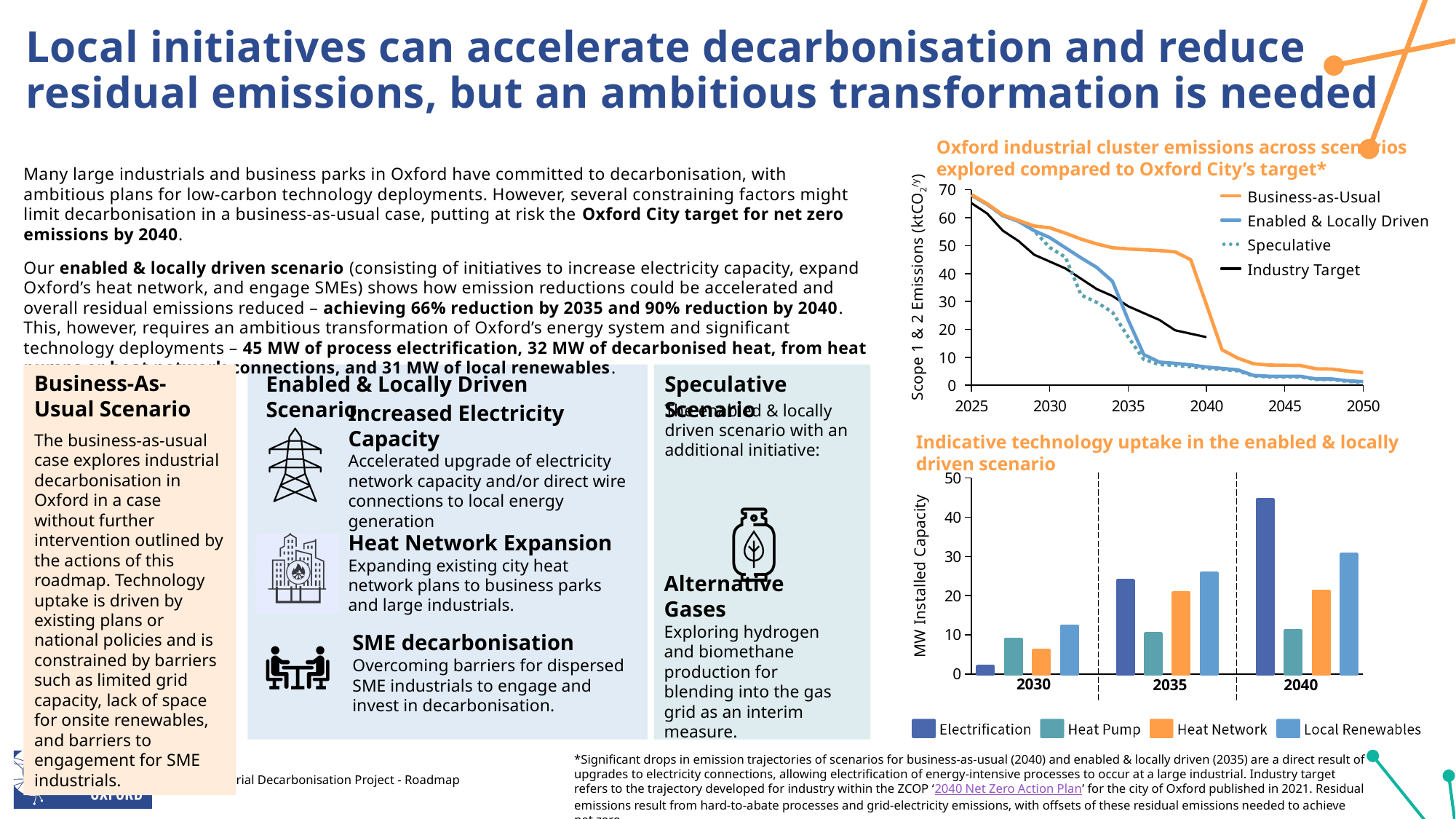
In the 'Indicative technology uptake' chart, is the Electrification value in 2040 greater or less than 40? greater How many year categories are shown on the x axis of the 'Indicative technology uptake' chart? 3 How many series does the legend of the 'Oxford industrial cluster emissions across scenarios' chart list? 4 What type of chart is the 'Indicative technology uptake in the enabled & locally driven scenario' chart? Bar chart In the 'Oxford industrial cluster emissions across scenarios' chart, do the emissions values rise or fall from 2025 to 2050? Fall In the 'Oxford industrial cluster emissions across scenarios' chart, is the Business-as-Usual value in 2035 greater or less than 40? greater In the 'Oxford industrial cluster emissions across scenarios' chart, is the Enabled & Locally Driven value in 2040 greater or less than 10? less In the 'Indicative technology uptake' chart, which is larger in 2035: Electrification or Heat Pump? Electrification What type of chart is the 'Oxford industrial cluster emissions across scenarios' chart? Line chart In the 'Oxford industrial cluster emissions across scenarios' chart, which series is drawn as a dotted line? Speculative In the 'Oxford industrial cluster emissions across scenarios' chart, which series has the highest value in 2035? Business-as-Usual In the 'Indicative technology uptake' chart, which technology has the tallest bar in 2040? Electrification